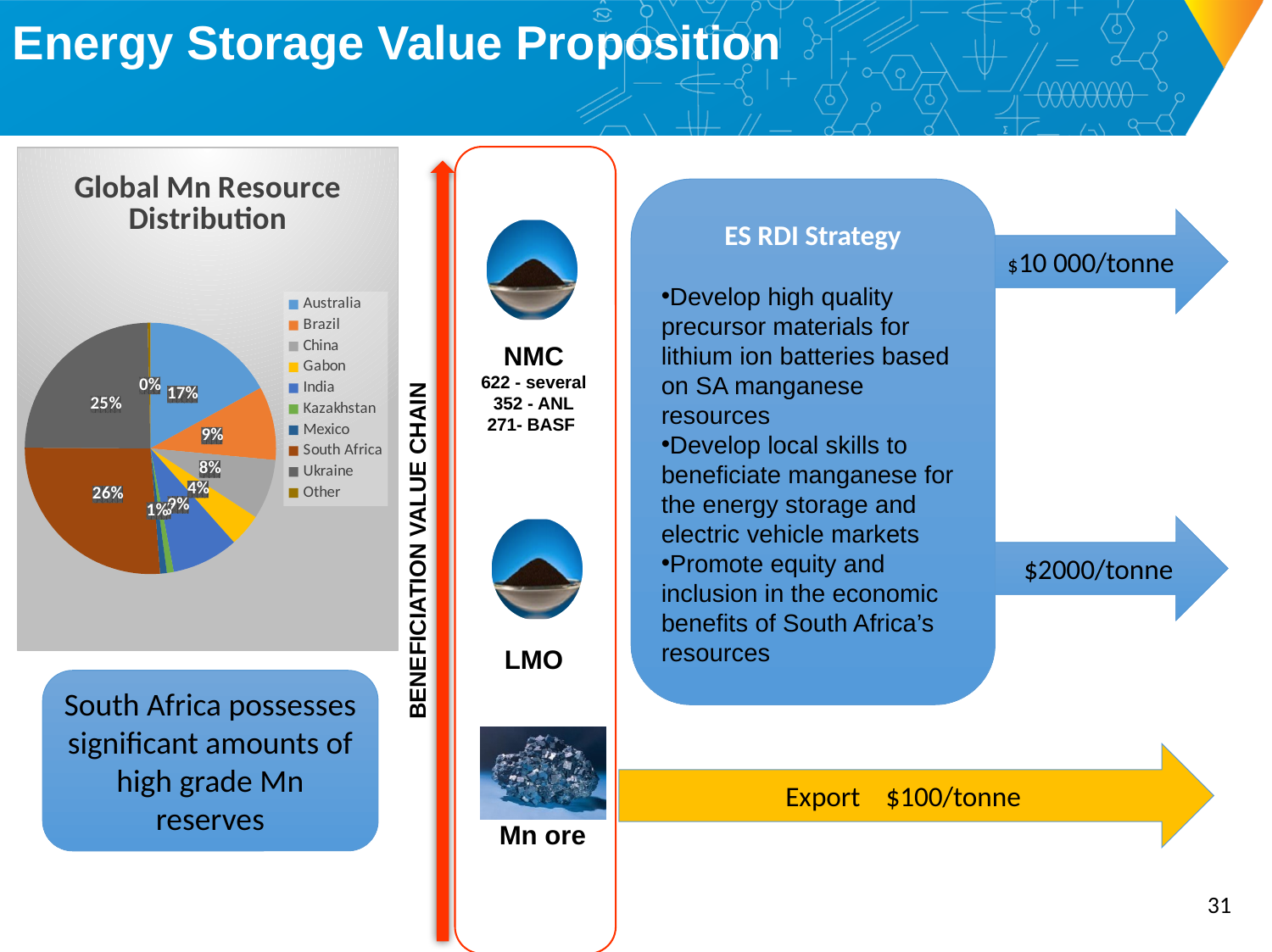
What type of chart is shown under the title "Global Mn Resource Distribution"? pie chart In the Global Mn Resource Distribution pie chart, what share is labelled for Ukraine? 25% In the Global Mn Resource Distribution pie chart, what share is labelled for Gabon? 4% Which country has the largest slice in the Global Mn Resource Distribution pie chart? South Africa What colour is the South Africa slice in the Global Mn Resource Distribution pie chart? brown In the Global Mn Resource Distribution pie chart, what is the difference between South Africa's share and Australia's share? 9% In the Global Mn Resource Distribution pie chart, what share is labelled for South Africa? 26% In the Global Mn Resource Distribution pie chart, what share is labelled for Brazil? 9% How many entries does the legend of the Global Mn Resource Distribution pie chart list? 10 In the Global Mn Resource Distribution pie chart, what share is labelled for Australia? 17% In the Global Mn Resource Distribution pie chart, which has the larger share, Brazil or Australia? Australia Which legend entry has the smallest share (0%) in the Global Mn Resource Distribution pie chart? Other